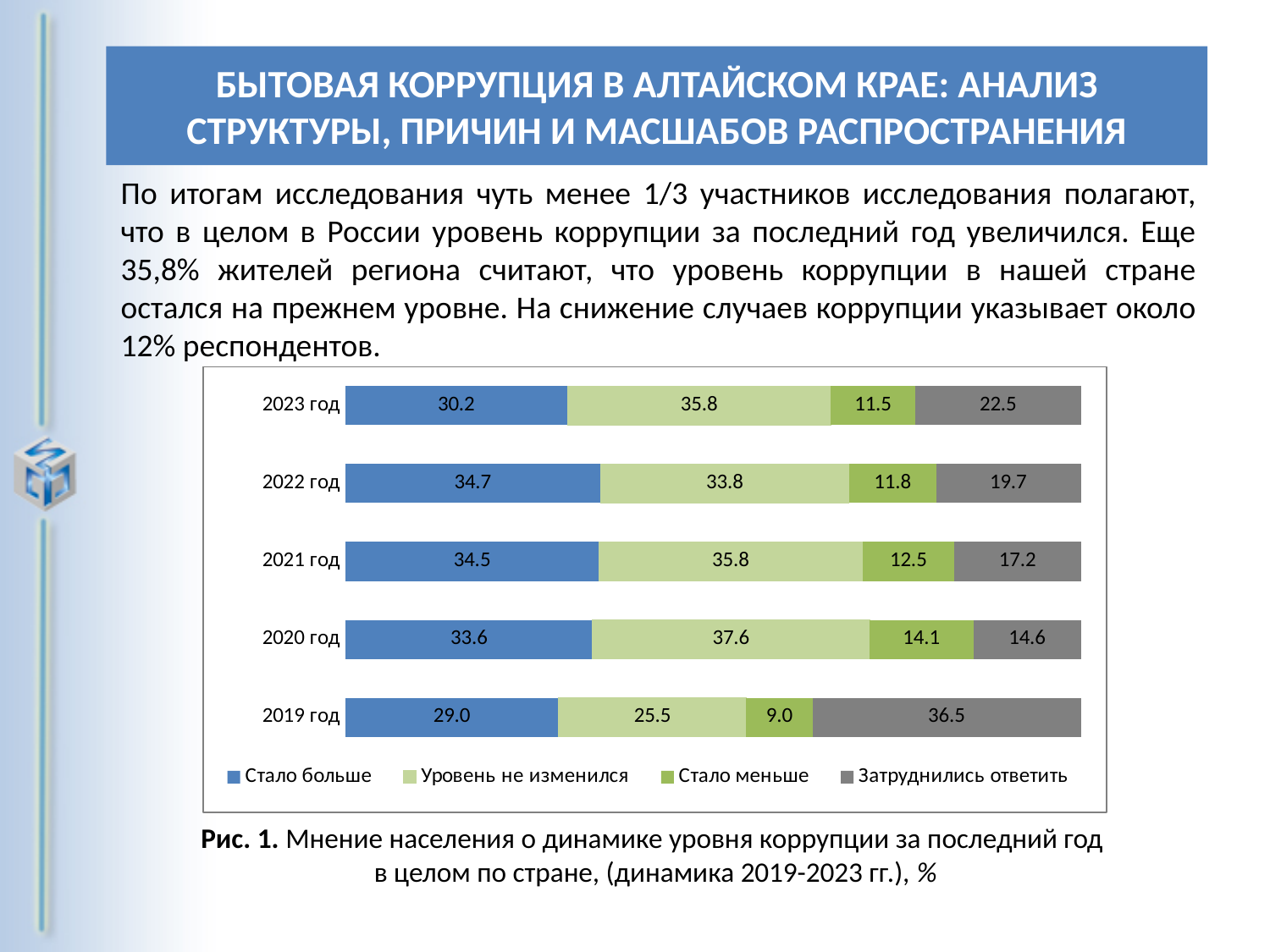
Which series is shown in dark grey in the legend? Затруднились ответить What is the value for "Уровень не изменился" in 2020 год? 37.6 What kind of chart is shown on the slide? Stacked bar chart What is the difference between the "Стало больше" values for 2022 год and 2023 год? 4.5 In which year is the value for "Стало меньше" the lowest? 2019 год What is the value for "Стало больше" in 2023 год? 30.2 How many series does the legend list? 4 In which year is the value for "Затруднились ответить" the highest? 2019 год What is the value for "Затруднились ответить" in 2019 год? 36.5 How many years (categories) are shown in the chart? 5 Which is larger: "Уровень не изменился" in 2019 год or in 2021 год? 2021 год What is the total of the stacked bar for 2021 год? 100.0